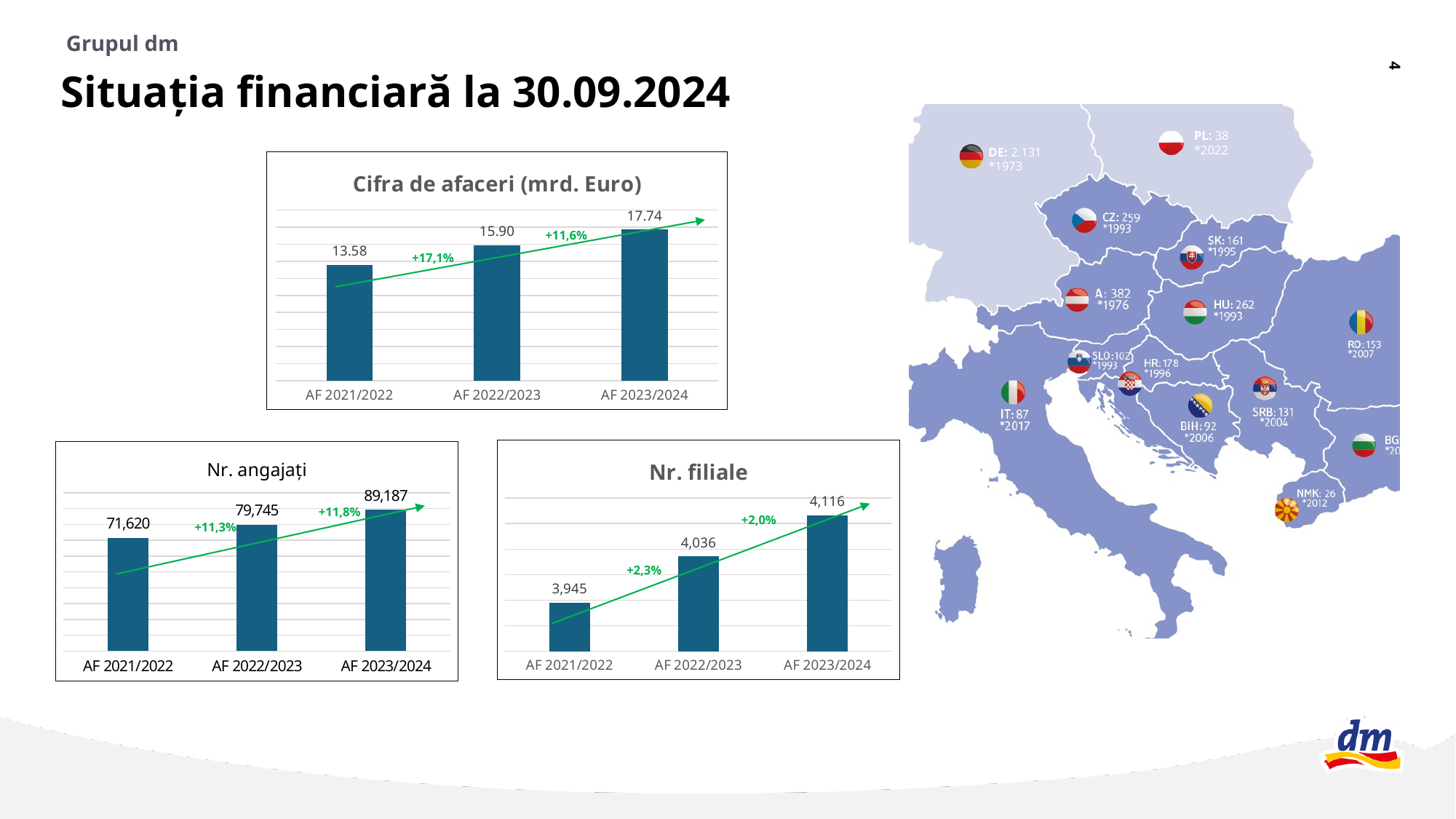
What kind of chart is the 'Nr. angajați' chart? bar chart In the 'Nr. filiale' chart, what is the value for AF 2021/2022? 3,945 In the 'Nr. angajați' chart, what is the difference between AF 2023/2024 and AF 2021/2022? 17,567 How many fiscal years are shown on the x axis of the 'Nr. filiale' chart? 3 In the 'Cifra de afaceri (mrd. Euro)' chart, what is the percentage growth shown between AF 2021/2022 and AF 2022/2023? +17,1% In the 'Nr. angajați' chart, which fiscal year has the highest value? AF 2023/2024 In the 'Nr. filiale' chart, what is the difference between AF 2023/2024 and AF 2022/2023? 80 In the 'Cifra de afaceri (mrd. Euro)' chart, what is the value for AF 2023/2024? 17.74 In the 'Nr. filiale' chart, do the values rise or fall from AF 2021/2022 to AF 2023/2024? rise In the 'Cifra de afaceri (mrd. Euro)' chart, which fiscal year has the lowest value? AF 2021/2022 In the 'Cifra de afaceri (mrd. Euro)' chart, what is the value for AF 2021/2022? 13.58 In the 'Nr. angajați' chart, what is the value for AF 2022/2023? 79,745